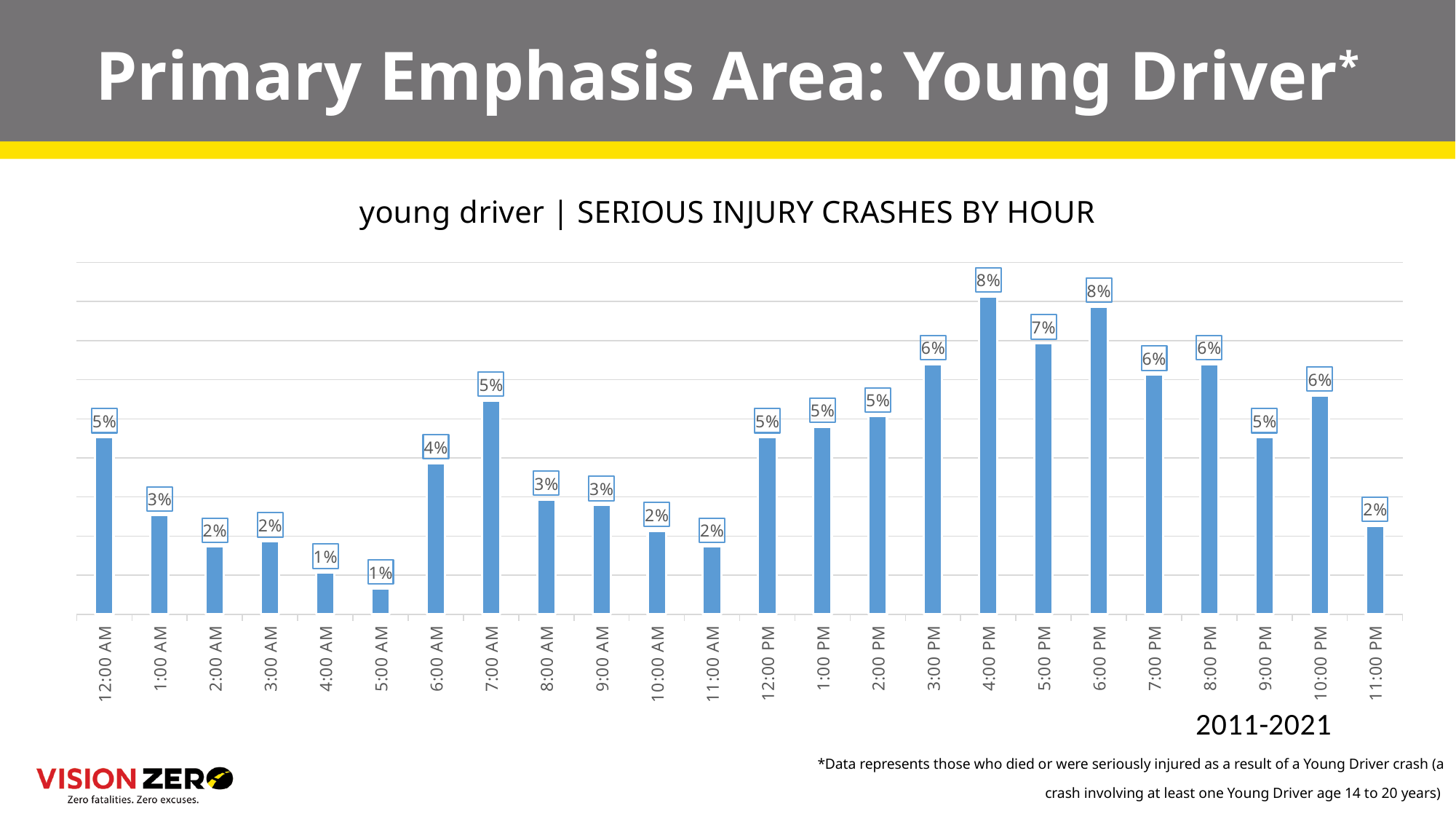
What is the value for 11:00 PM? 2% What is the difference between the values for 4:00 PM and 11:00 PM? 6% What is the difference between the values for 5:00 PM and 1:00 AM? 4% What is the value for 5:00 AM? 1% What kind of chart is shown on the slide? Bar chart What is the value for 4:00 PM? 8% What is the value for 5:00 PM? 7% Which is larger, the value for 6:00 PM or the value for 9:00 PM? 6:00 PM How many hour categories are shown on the x axis? 24 Do the values rise or fall from 12:00 AM to 5:00 AM? Fall What is the value for 7:00 AM? 5% Which is larger, the value for 7:00 AM or the value for 1:00 AM? 7:00 AM